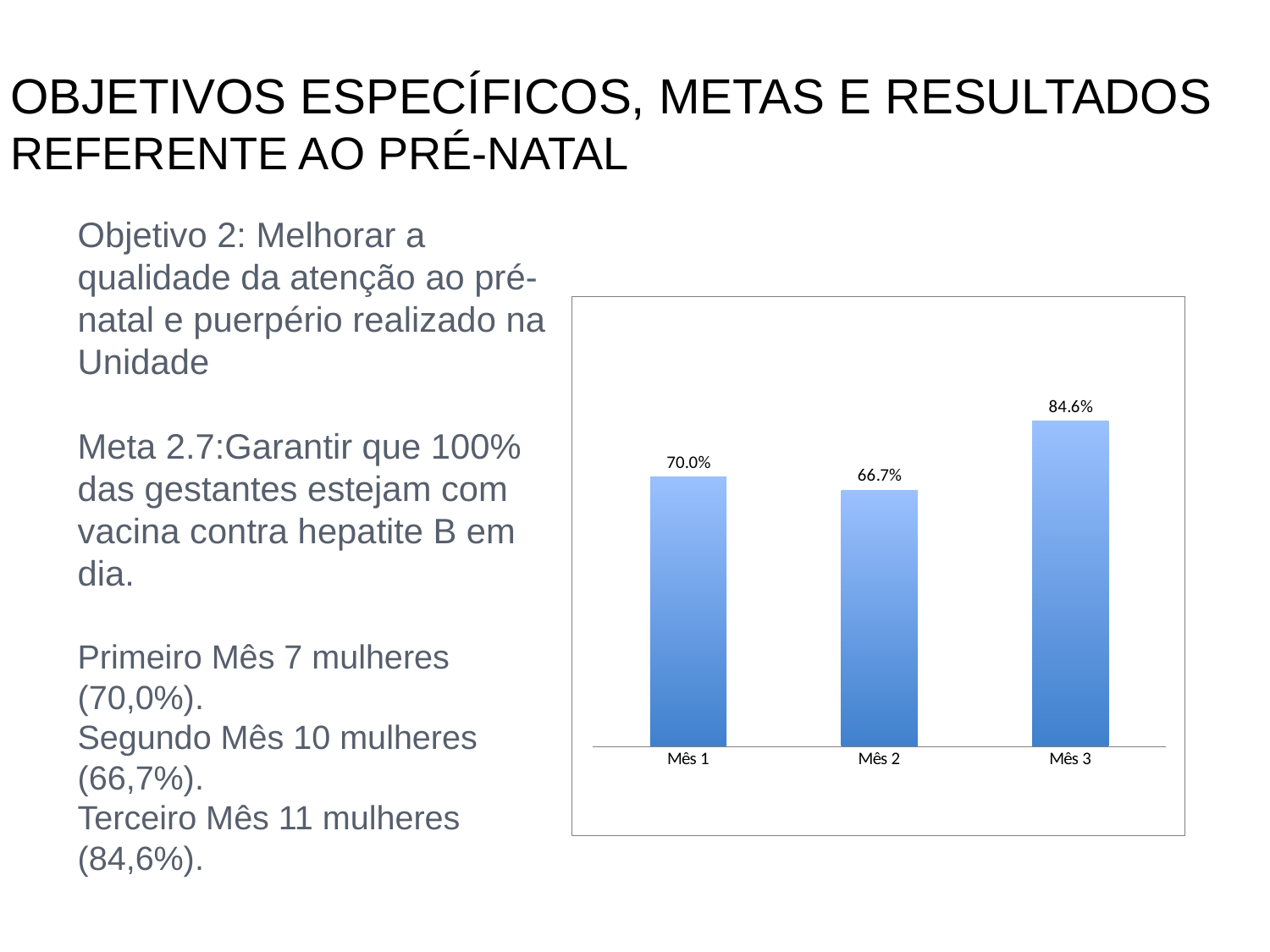
What kind of chart is shown on the slide? Bar chart What is the difference between the values for Mês 1 and Mês 2? 3.3% Does the value rise or fall from Mês 2 to Mês 3? Rise What is the value for Mês 3? 84.6% Which month has the highest value? Mês 3 Which is larger, the value for Mês 2 or the value for Mês 3? Mês 3 What is the value for Mês 1? 70.0% What is the difference between the values for Mês 3 and Mês 1? 14.6% What is the value for Mês 2? 66.7% What is the label of the first category on the x axis? Mês 1 How many categories are shown on the x axis of the chart? 3 Which month has the lowest value? Mês 2